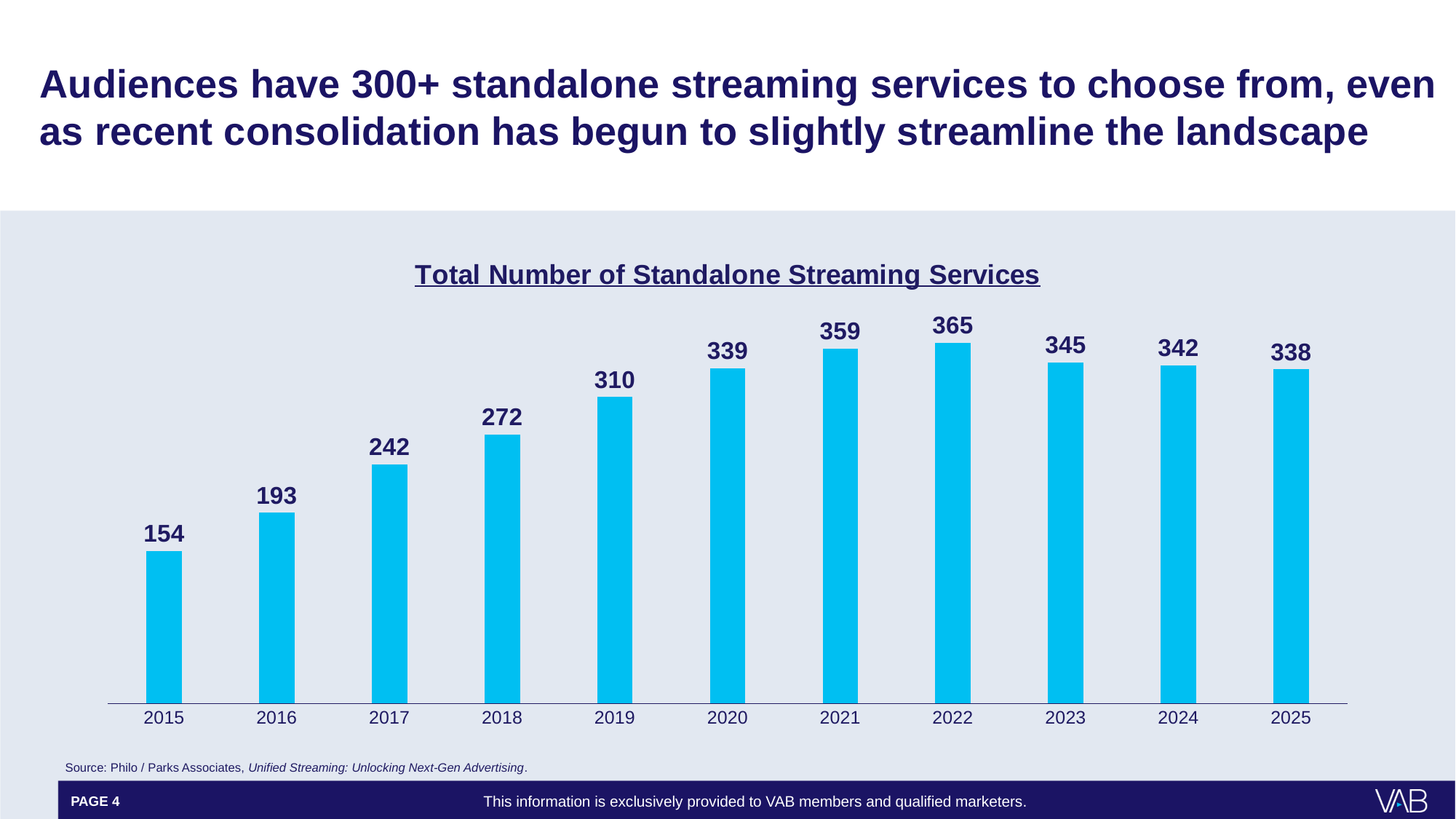
What is the total number of standalone streaming services in 2015? 154 Which year has the highest total number of standalone streaming services? 2022 Which year has more standalone streaming services, 2019 or 2020? 2020 How many years are shown on the x axis of the chart? 11 What is the total number of standalone streaming services in 2022? 365 What kind of chart is used to show the total number of standalone streaming services? Bar chart What is the title of the chart? Total Number of Standalone Streaming Services Which year has the lowest total number of standalone streaming services? 2015 What is the total number of standalone streaming services in 2025? 338 What is the difference between the number of standalone streaming services in 2022 and in 2025? 27 Do the values rise or fall from 2015 to 2022? Rise What is the difference between the number of standalone streaming services in 2016 and in 2015? 39